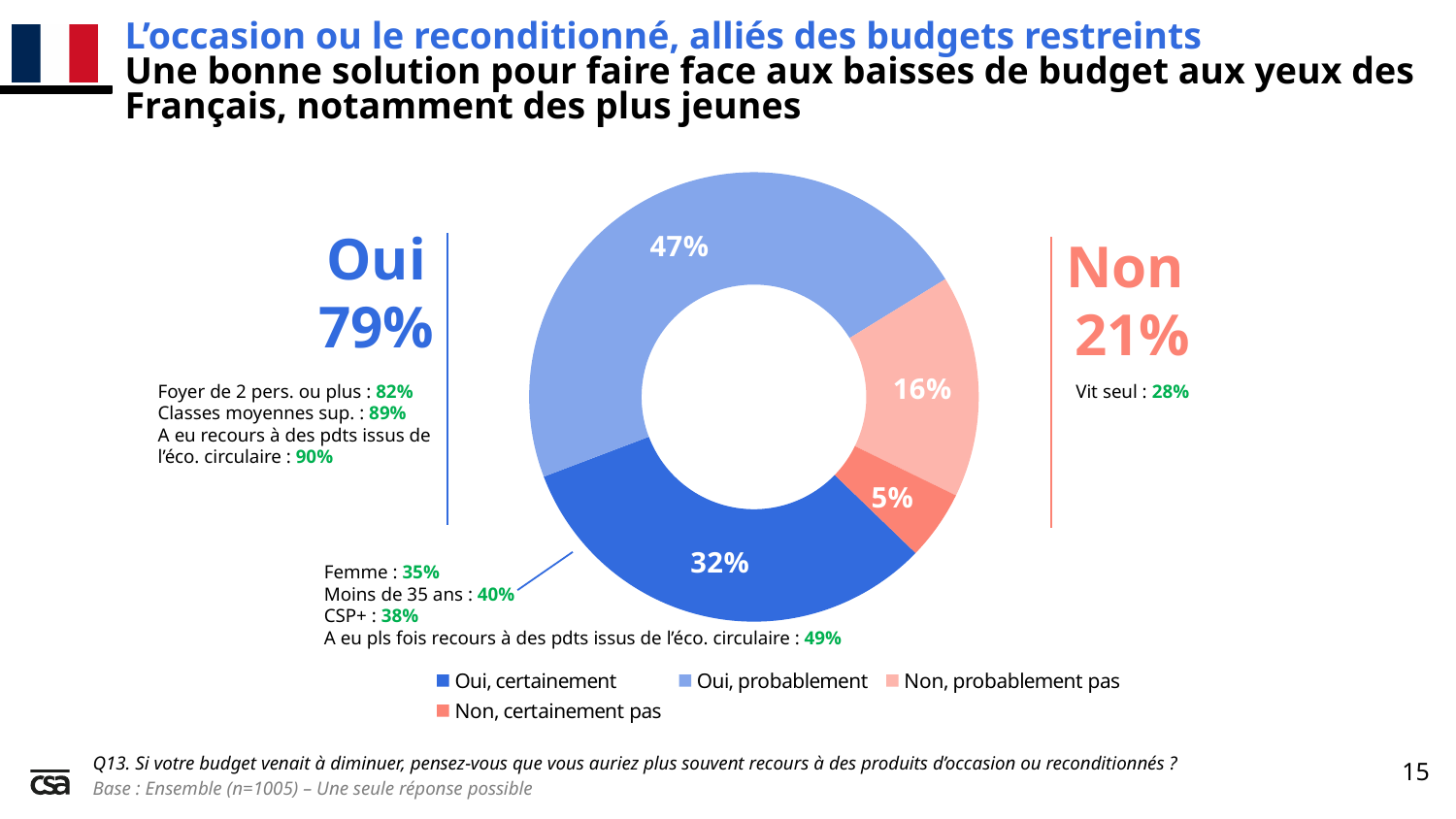
What percentage of respondents answered "Non, certainement pas"? 5% What is the combined share of the two "Oui" slices, as shown on the slide? 79% Which response category has the smallest share of the pie? Non, certainement pas What is the difference between the "Oui, probablement" share and the "Oui, certainement" share? 15% What percentage of respondents answered "Oui, certainement"? 32% How many entries does the legend list? 4 What kind of chart is shown on the slide? Pie chart (donut) What percentage of respondents answered "Oui, probablement"? 47% Which response category has the largest share of the pie? Oui, probablement What percentage of respondents answered "Non, probablement pas"? 16% How many slices does the pie chart have? 4 Which is larger: the share for "Non, probablement pas" or the share for "Non, certainement pas"? Non, probablement pas